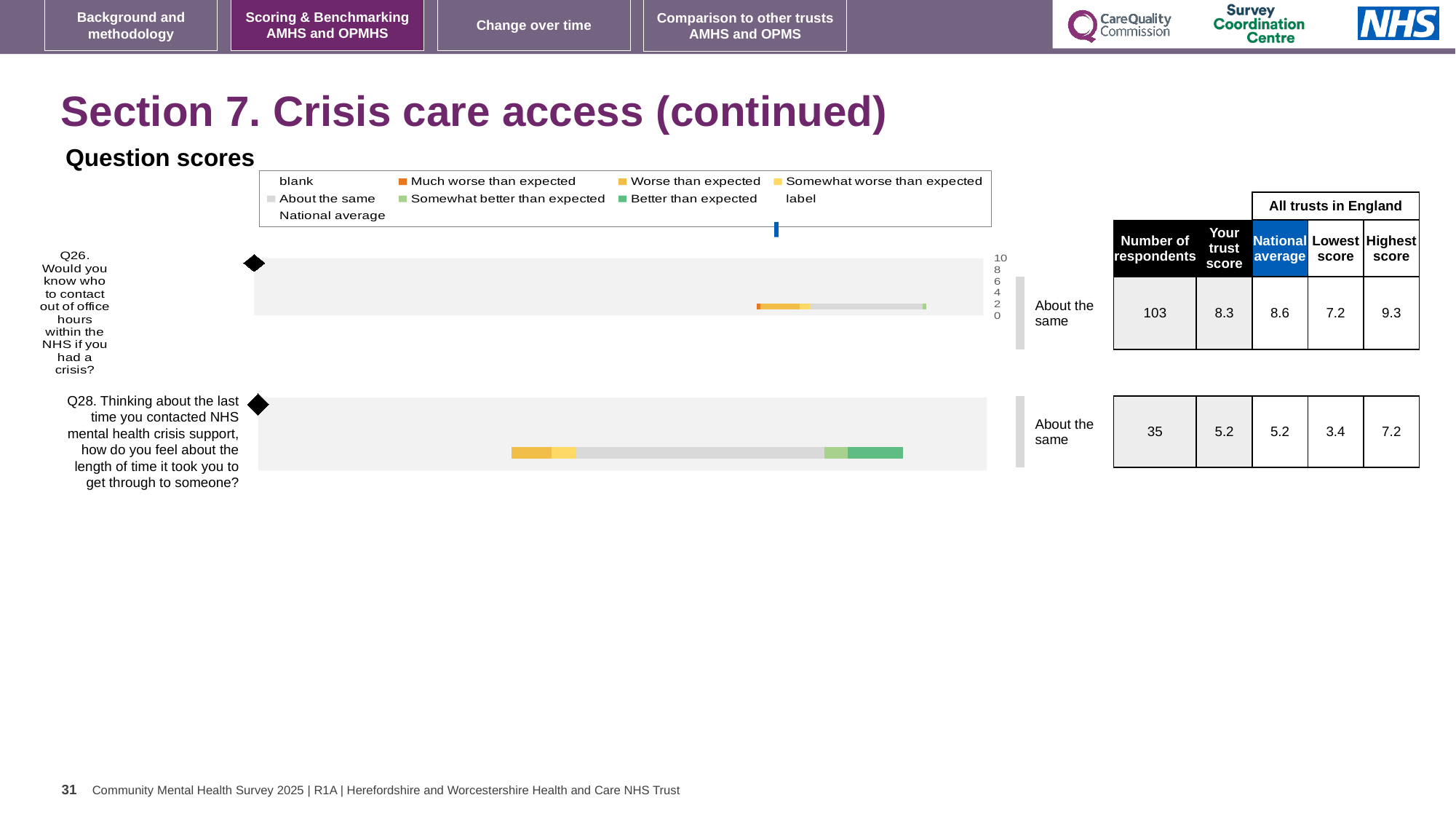
What is the difference between the highest and lowest scores for Q28? 3.8 For Q26, which is larger: the trust score or the national average? National average How many entries does the legend of the question scores chart list? 9 What benchmark category label is shown beside the bar for Q28? About the same What is the national average for Q28 shown in the table? 5.2 What is the lowest score across all trusts in England for Q28? 3.4 What kind of chart is used to show the question scores on this slide? Bar chart What is the trust score for Q26 shown in the table? 8.3 How many more respondents answered Q26 than Q28? 68 How many questions are plotted in the question scores chart? 2 What is the highest score across all trusts in England for Q26? 9.3 What is the number of respondents for Q26 in the table next to the chart? 103